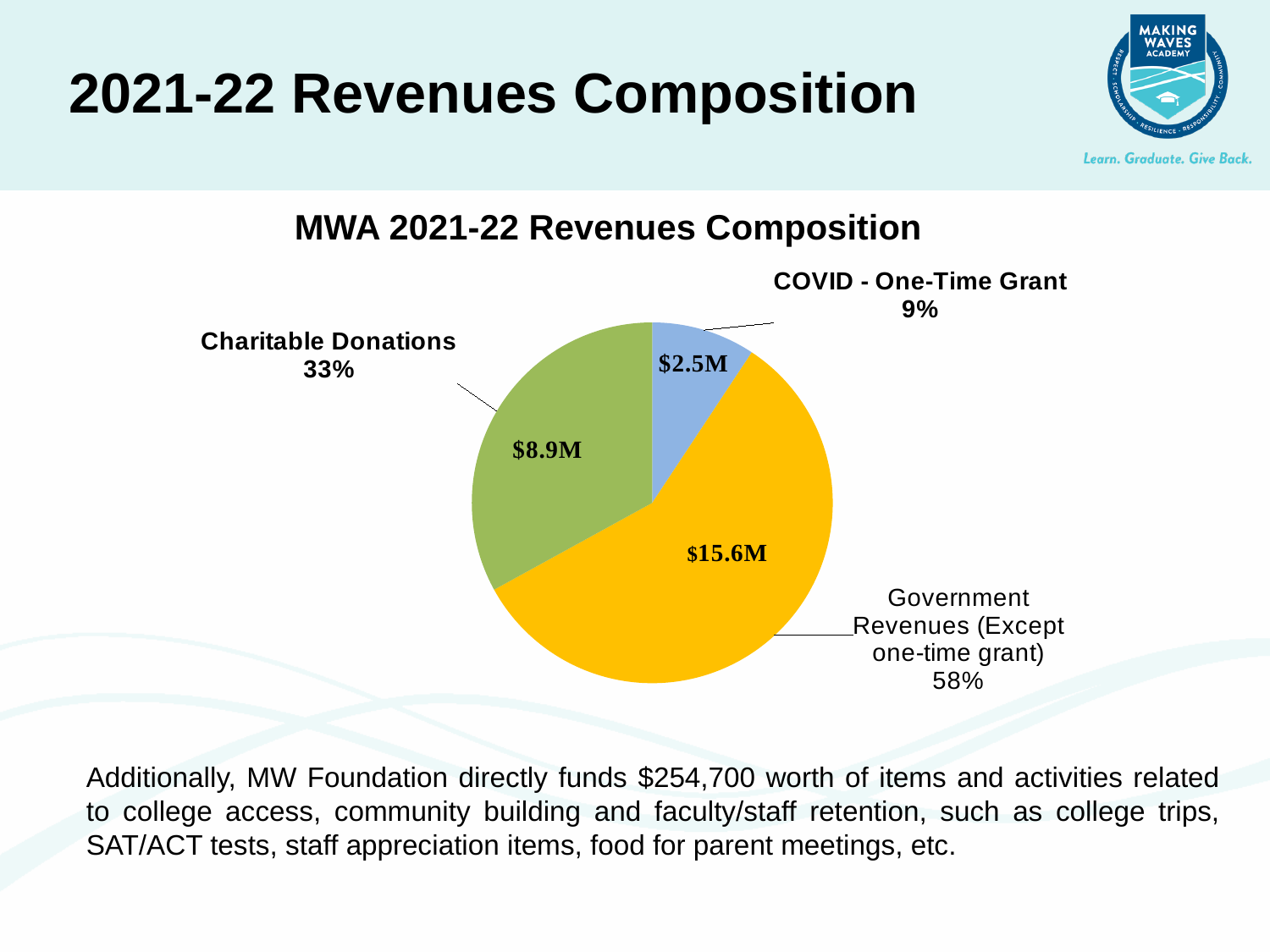
How many slices does the pie chart have? 3 What is the title of the chart? MWA 2021-22 Revenues Composition Which category has the largest slice of the pie? Government Revenues (Except one-time grant) What share of the pie does COVID - One-Time Grant represent? 9% What is the value shown for Government Revenues (Except one-time grant)? $15.6M What is the value shown for COVID - One-Time Grant? $2.5M Which category has the smallest slice of the pie? COVID - One-Time Grant What is the value shown for Charitable Donations? $8.9M What share of the pie does Charitable Donations represent? 33% What kind of chart is shown on the slide? pie chart Which is larger, Charitable Donations or COVID - One-Time Grant? Charitable Donations What is the difference between the Government Revenues (Except one-time grant) value and the Charitable Donations value? $6.7M